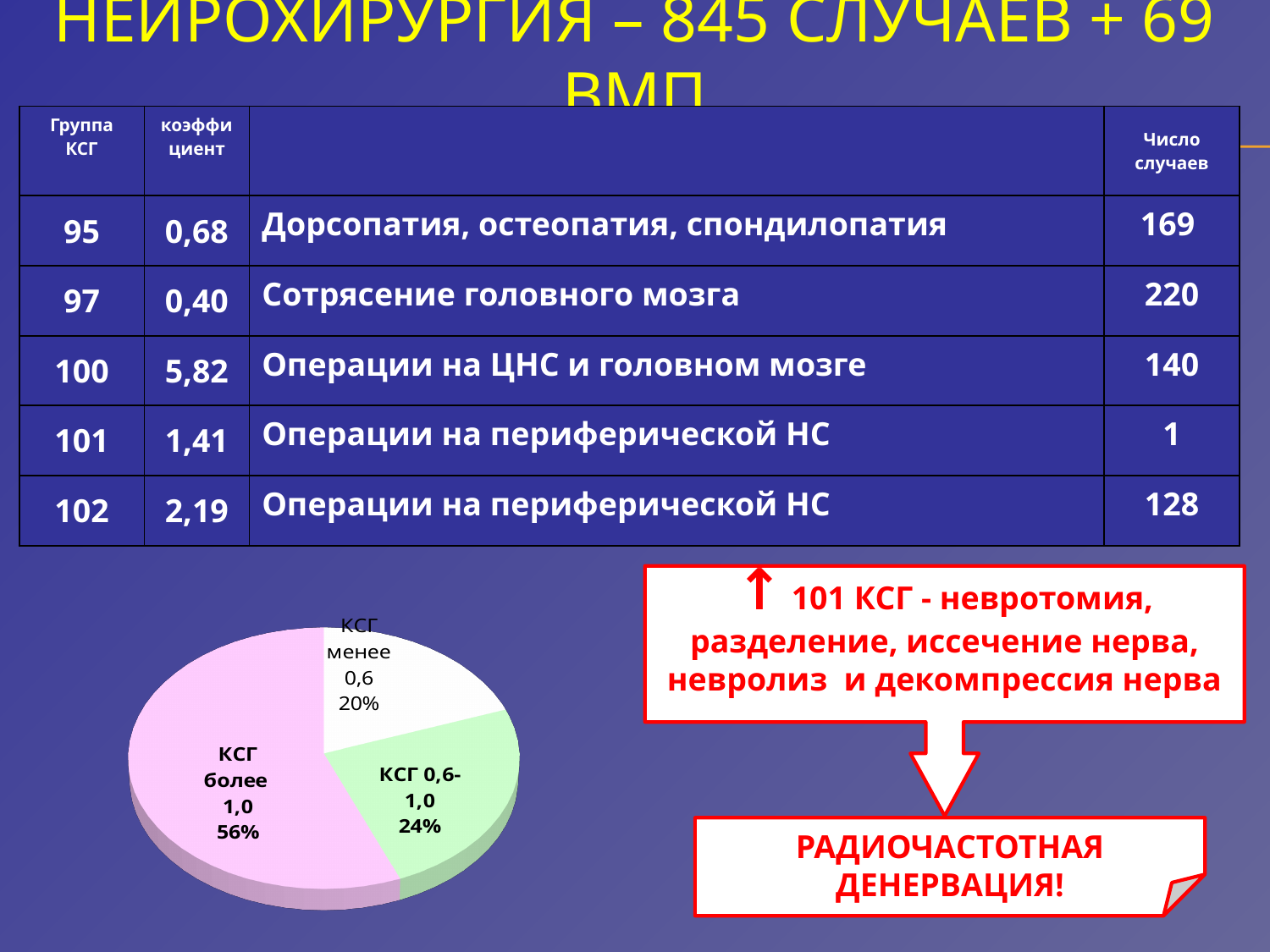
What share of the pie does the slice "КСГ 0,6-1,0" have? 24% What share of the pie does the slice "КСГ менее 0,6" have? 20% Which slice of the pie chart is the largest? КСГ более 1,0 What kind of chart is shown on the slide? pie chart Which slice of the pie chart is the smallest? КСГ менее 0,6 What colour is the "КСГ более 1,0" slice of the pie chart? pink What is the difference in percentage points between the "КСГ 0,6-1,0" slice and the "КСГ менее 0,6" slice? 4 What colour is the "КСГ 0,6-1,0" slice of the pie chart? light green How many slices does the pie chart have? 3 Which slice is larger: "КСГ 0,6-1,0" or "КСГ менее 0,6"? КСГ 0,6-1,0 What share of the pie does the slice "КСГ более 1,0" have? 56% What is the difference in percentage points between the "КСГ более 1,0" slice and the "КСГ 0,6-1,0" slice? 32